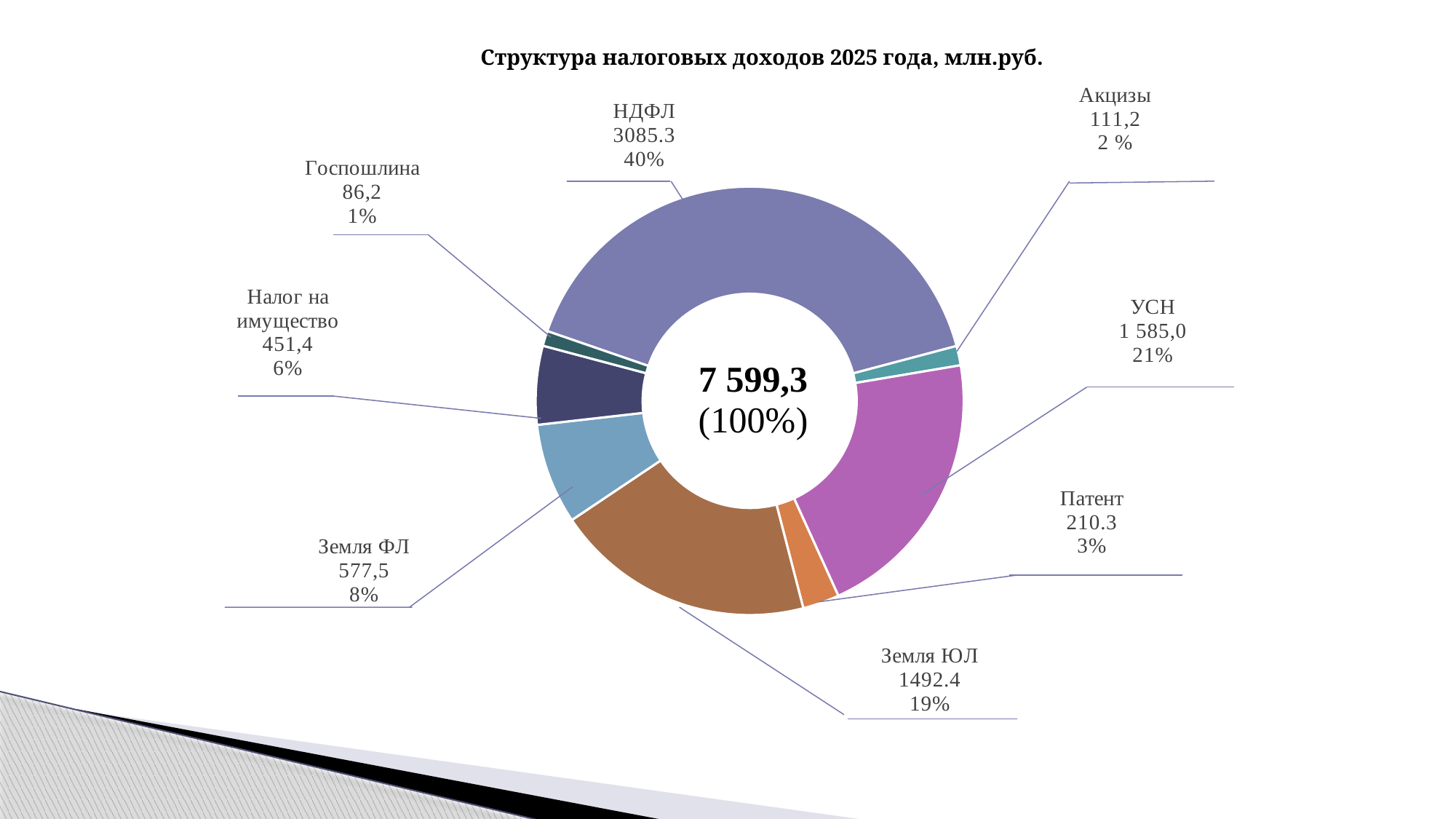
What total value is shown in the centre of the chart? 7 599,3 How many categories are shown in the chart? 8 Which category has the largest value? НДФЛ What is the difference between the values for Патент and Акцизы? 99,1 What is the title of the chart? Структура налоговых доходов 2025 года, млн.руб. What share of the total does Земля ФЛ account for? 8% What is the value for Земля ЮЛ? 1492.4 Which category has the smallest value? Госпошлина Which is larger, Земля ФЛ or Налог на имущество? Земля ФЛ What kind of chart is shown on the slide? Doughnut (pie) chart What share of the total does УСН account for? 21% What is the value for НДФЛ? 3085.3